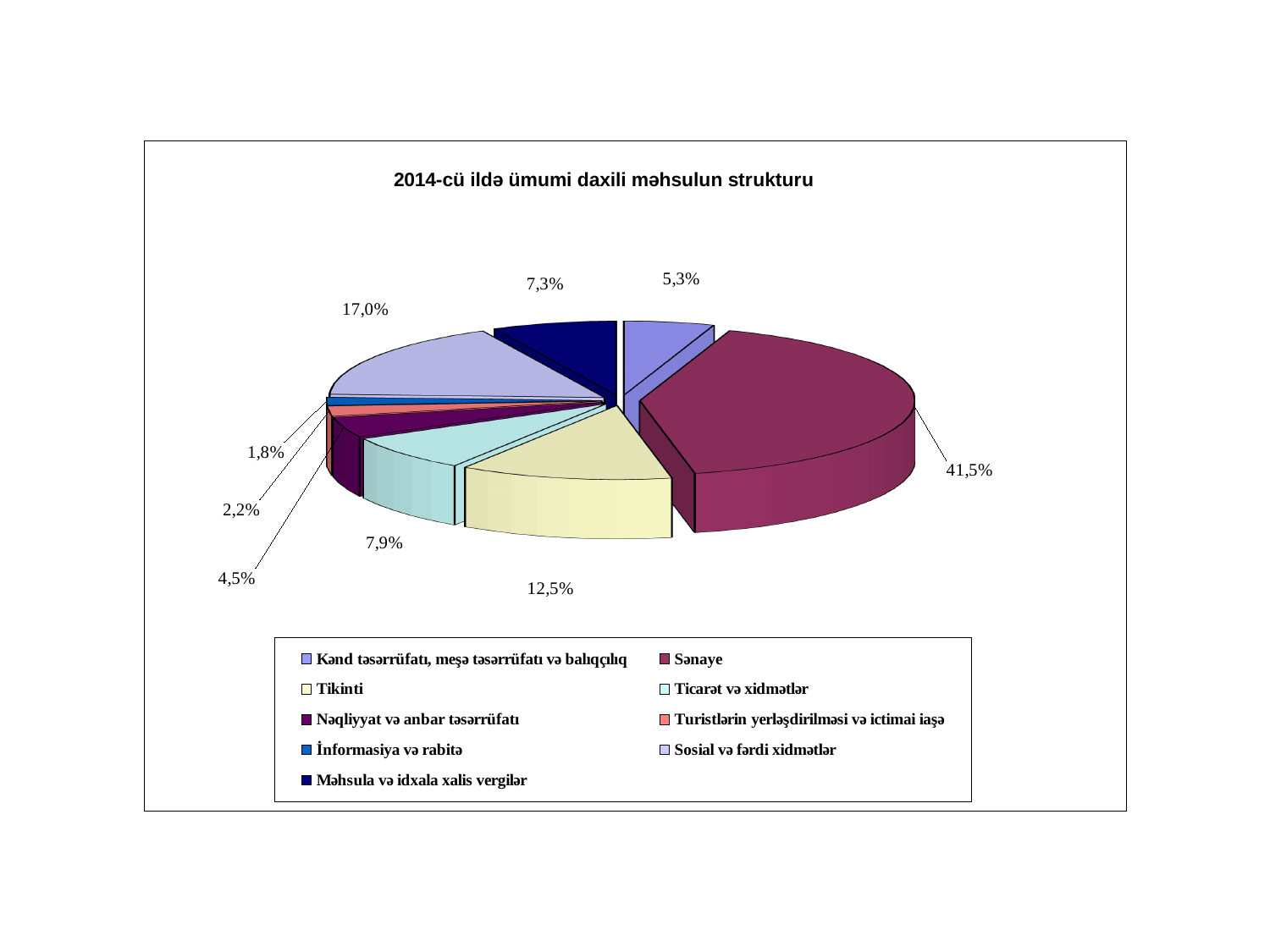
How many categories are shown in the pie chart? 9 What share of the pie does Sənaye account for? 41,5% What type of chart is shown on the slide? Pie chart Which category has the smallest slice of the pie? İnformasiya və rabitə What is the title of the chart? 2014-cü ildə ümumi daxili məhsulun strukturu What share is shown for Məhsula və idxala xalis vergilər? 7,3% What is the difference between the shares of Sənaye and Sosial və fərdi xidmətlər? 24,5% What percentage is shown for Sosial və fərdi xidmətlər? 17,0% What is the value shown for Tikinti? 12,5% What is the value for Ticarət və xidmətlər? 7,9% Which category has the largest slice of the pie? Sənaye Which is larger, the share for Tikinti or the share for Ticarət və xidmətlər? Tikinti